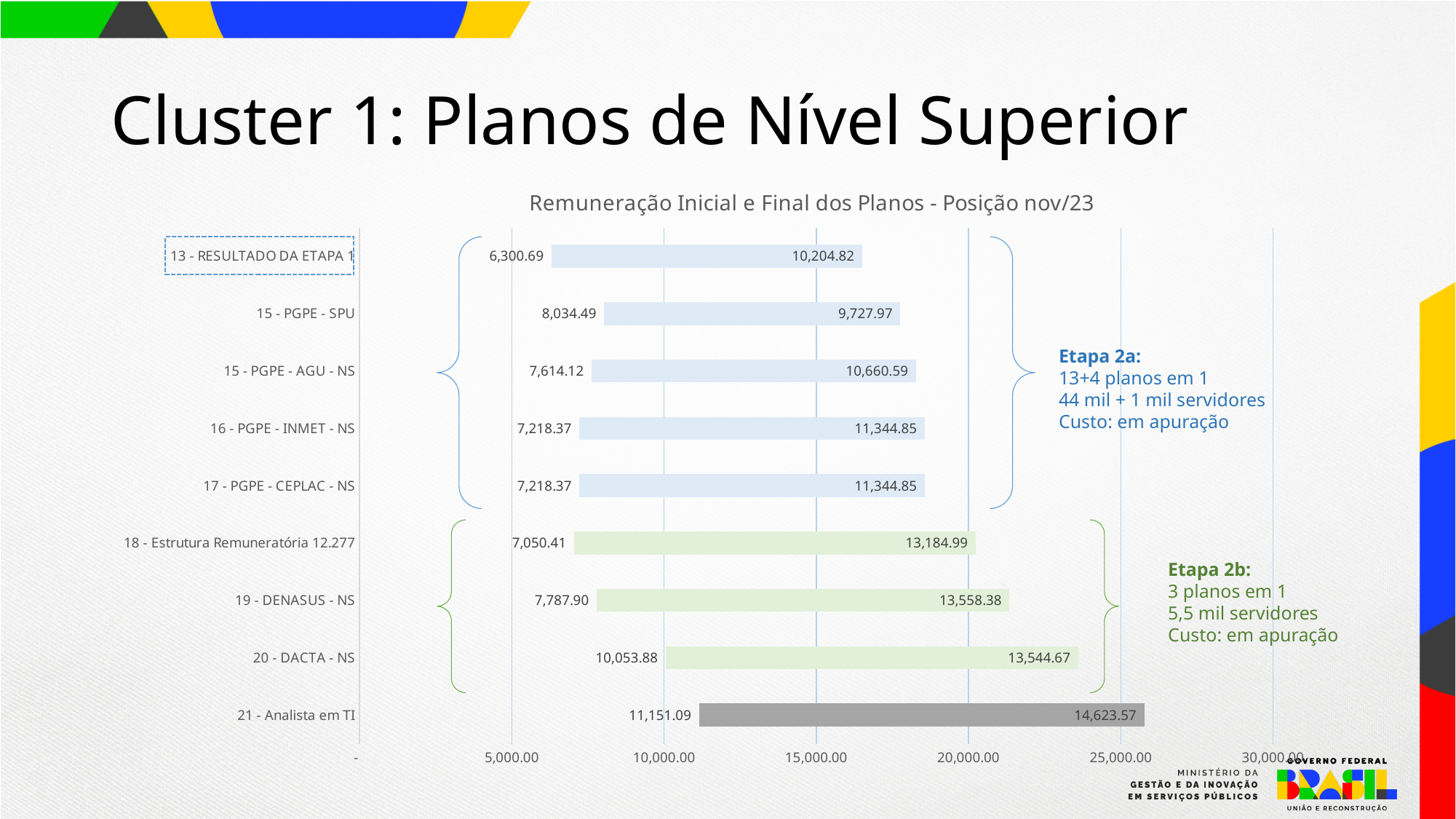
What is the initial remuneration value shown for '20 - DACTA - NS'? 10,053.88 What is the final remuneration value shown for '18 - Estrutura Remuneratória 12.277'? 13,184.99 What is the initial remuneration value shown for '13 - RESULTADO DA ETAPA 1'? 6,300.69 What is the final remuneration value shown for '15 - PGPE - SPU'? 9,727.97 What is the title of the chart? Remuneração Inicial e Final dos Planos - Posição nov/23 Which has the larger final remuneration value shown: '19 - DENASUS - NS' or '20 - DACTA - NS'? 19 - DENASUS - NS How many plans (categories) are listed on the chart's vertical axis? 9 Which plans are drawn with green bars? 18 - Estrutura Remuneratória 12.277, 19 - DENASUS - NS, 20 - DACTA - NS Which plan has the highest final remuneration value shown? 21 - Analista em TI Which plan has the lowest initial remuneration value shown? 13 - RESULTADO DA ETAPA 1 What kind of chart is shown on the slide? bar chart What is the difference between the final and initial remuneration values shown for '13 - RESULTADO DA ETAPA 1'? 3,904.13